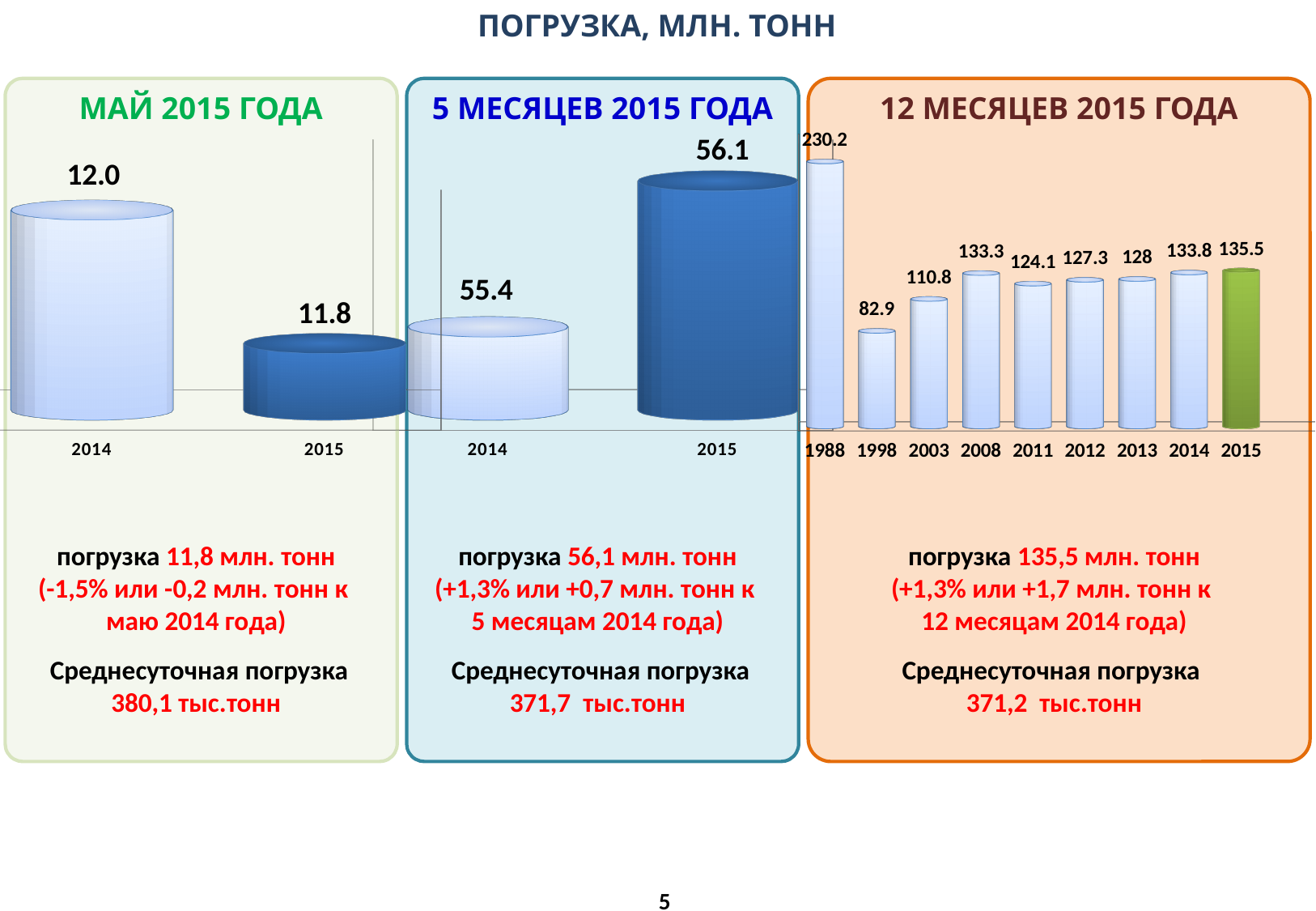
In the "12 МЕСЯЦЕВ 2015 ГОДА" chart, what is the value for 1988? 230.2 In the "12 МЕСЯЦЕВ 2015 ГОДА" chart, how many years are shown? 9 In the "12 МЕСЯЦЕВ 2015 ГОДА" chart, which year has the highest value? 1988 In the "МАЙ 2015 ГОДА" chart, what is the value for 2014? 12.0 In the "12 МЕСЯЦЕВ 2015 ГОДА" chart, which year has the lowest value? 1998 In the "5 МЕСЯЦЕВ 2015 ГОДА" chart, what is the difference between the 2015 and 2014 values? 0.7 In the "5 МЕСЯЦЕВ 2015 ГОДА" chart, what is the value for 2015? 56.1 In the "12 МЕСЯЦЕВ 2015 ГОДА" chart, what is the difference between the 2015 and 2014 values? 1.7 In the "МАЙ 2015 ГОДА" chart, what is the difference between the 2014 and 2015 values? 0.2 What kind of chart is the "12 МЕСЯЦЕВ 2015 ГОДА" chart? Bar chart In the "5 МЕСЯЦЕВ 2015 ГОДА" chart, which year has the larger value, 2014 or 2015? 2015 In the "МАЙ 2015 ГОДА" chart, what is the value for 2015? 11.8